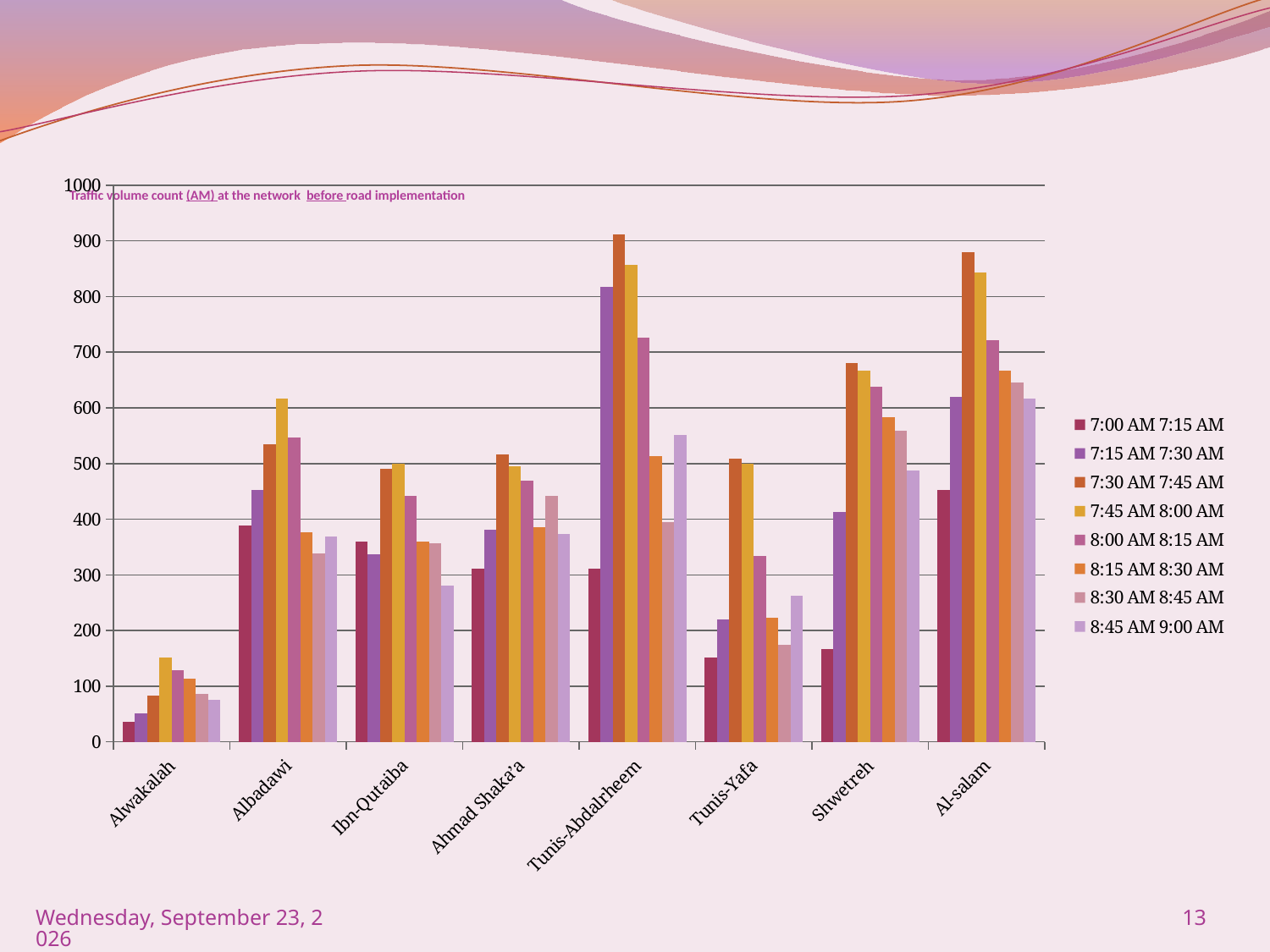
For Alwakalah, which time interval has the highest traffic volume? 7:45 AM 8:00 AM How many locations (categories) are shown on the x axis of the chart? 8 Which time interval is the last entry in the legend? 8:45 AM 9:00 AM Is the 7:00 AM 7:15 AM value for Alwakalah greater or less than 100? less What kind of chart is shown on the slide? bar chart For Tunis-Abdalrheem, which time interval has the highest traffic volume? 7:30 AM 7:45 AM How many time-interval series does the legend list? 8 What is the title of the chart? Traffic volume count (AM) at the network before road implementation For Al-salam, do the values rise or fall from the 7:30 AM 7:45 AM interval to the 8:45 AM 9:00 AM interval? fall Which location has the lowest traffic volumes overall across all time intervals? Alwakalah Which is larger: the 7:00 AM 7:15 AM value for Al-salam or the 7:00 AM 7:15 AM value for Tunis-Abdalrheem? Al-salam Is the 7:30 AM 7:45 AM value for Tunis-Abdalrheem greater or less than 800? greater